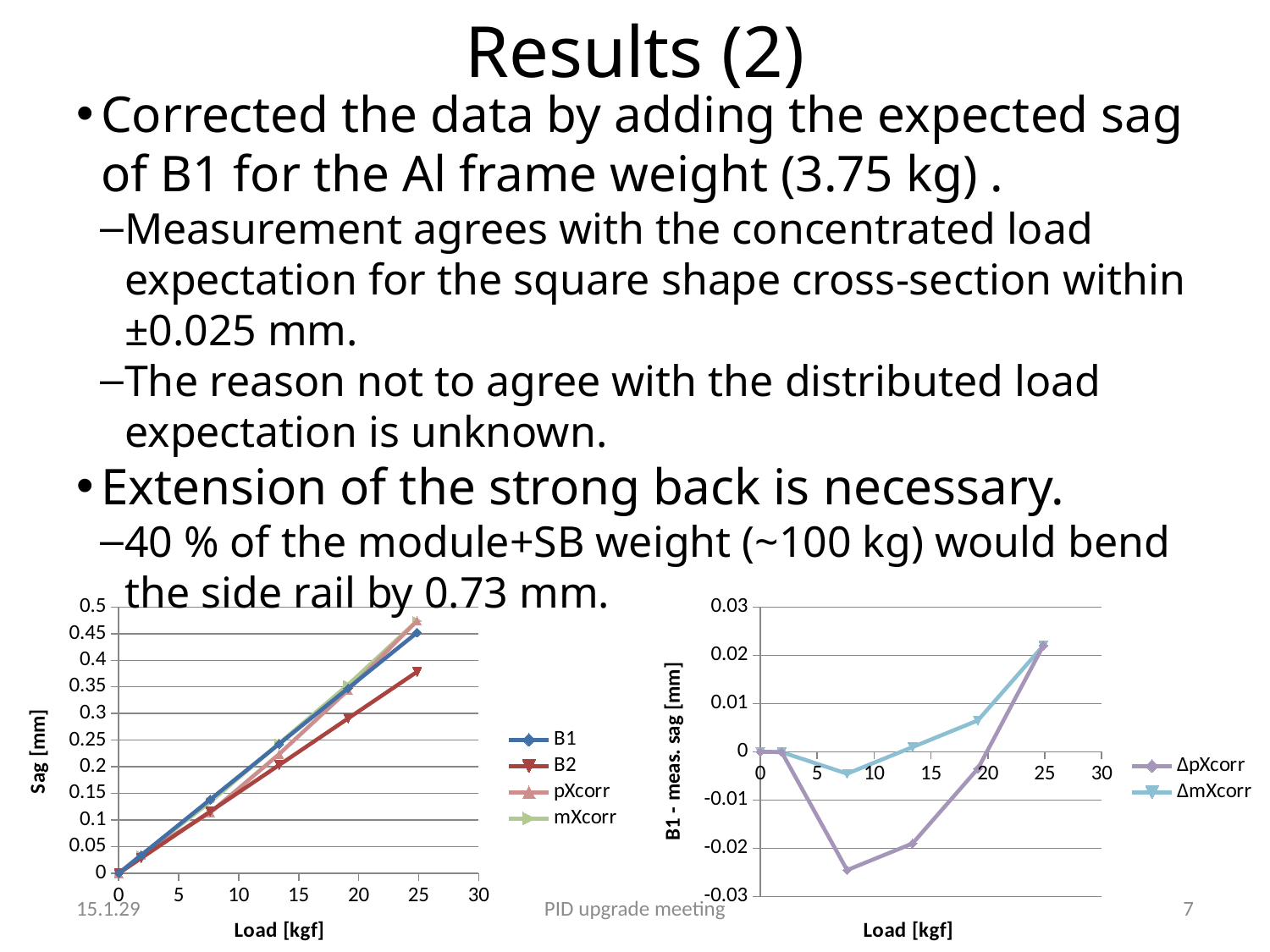
On the left chart (Sag vs Load), how many series does the legend list? 4 On the left chart (Sag vs Load), what is the label of the y axis? Sag [mm] On the left chart (Sag vs Load), do the values of B1 rise or fall as the load increases? rise On the right chart (B1 - meas. sag vs Load), is the value of ΔmXcorr at 25 kgf greater or less than 0.02? greater On the right chart (B1 - meas. sag vs Load), is the lowest value of ΔpXcorr greater or less than -0.02? less On the left chart (Sag vs Load), is the value of B2 at 25 kgf greater or less than 0.4? less On the left chart (Sag vs Load), what kind of chart is it? line chart On the right chart (B1 - meas. sag vs Load), how many data points does the ΔpXcorr series have? 6 On the right chart (B1 - meas. sag vs Load), which series has the larger value at about 7.5 kgf, ΔpXcorr or ΔmXcorr? ΔmXcorr On the right chart (B1 - meas. sag vs Load), how many series does the legend list? 2 On the left chart (Sag vs Load), which series has the larger value at 25 kgf, B1 or B2? B1